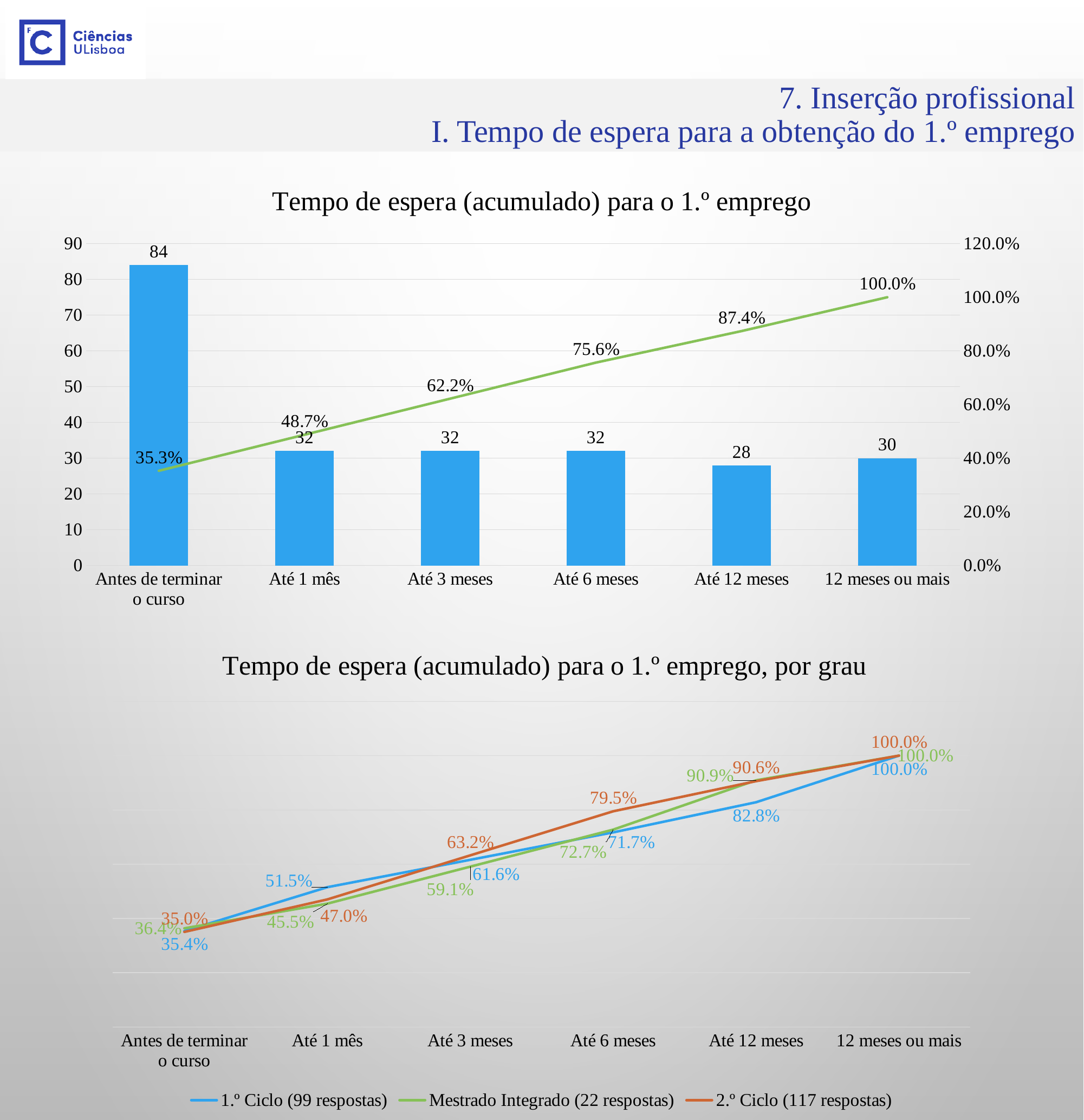
In the chart 'Tempo de espera (acumulado) para o 1.º emprego, por grau', what is the value for '2.º Ciclo (117 respostas)' at 'Até 6 meses'? 79.5% In the chart 'Tempo de espera (acumulado) para o 1.º emprego, por grau', what is the value for 'Mestrado Integrado (22 respostas)' at 'Até 12 meses'? 90.9% What kind of chart is 'Tempo de espera (acumulado) para o 1.º emprego, por grau'? line chart In the chart 'Tempo de espera (acumulado) para o 1.º emprego', what is the bar value for 'Antes de terminar o curso'? 84 In the chart 'Tempo de espera (acumulado) para o 1.º emprego', how many categories are shown on the x axis? 6 In the chart 'Tempo de espera (acumulado) para o 1.º emprego, por grau', which series has the larger value at 'Até 1 mês': '1.º Ciclo (99 respostas)' or 'Mestrado Integrado (22 respostas)'? 1.º Ciclo (99 respostas) In the chart 'Tempo de espera (acumulado) para o 1.º emprego', what is the difference between the bar values for 'Antes de terminar o curso' and 'Até 1 mês'? 52 In the chart 'Tempo de espera (acumulado) para o 1.º emprego, por grau', how many series does the legend list? 3 In the chart 'Tempo de espera (acumulado) para o 1.º emprego', what is the cumulative percentage at 'Até 6 meses'? 75.6% In the chart 'Tempo de espera (acumulado) para o 1.º emprego', which category has the highest bar value? Antes de terminar o curso In the chart 'Tempo de espera (acumulado) para o 1.º emprego', which category has the lowest bar value? Até 12 meses In the chart 'Tempo de espera (acumulado) para o 1.º emprego', does the cumulative percentage line rise or fall along the x axis? rise